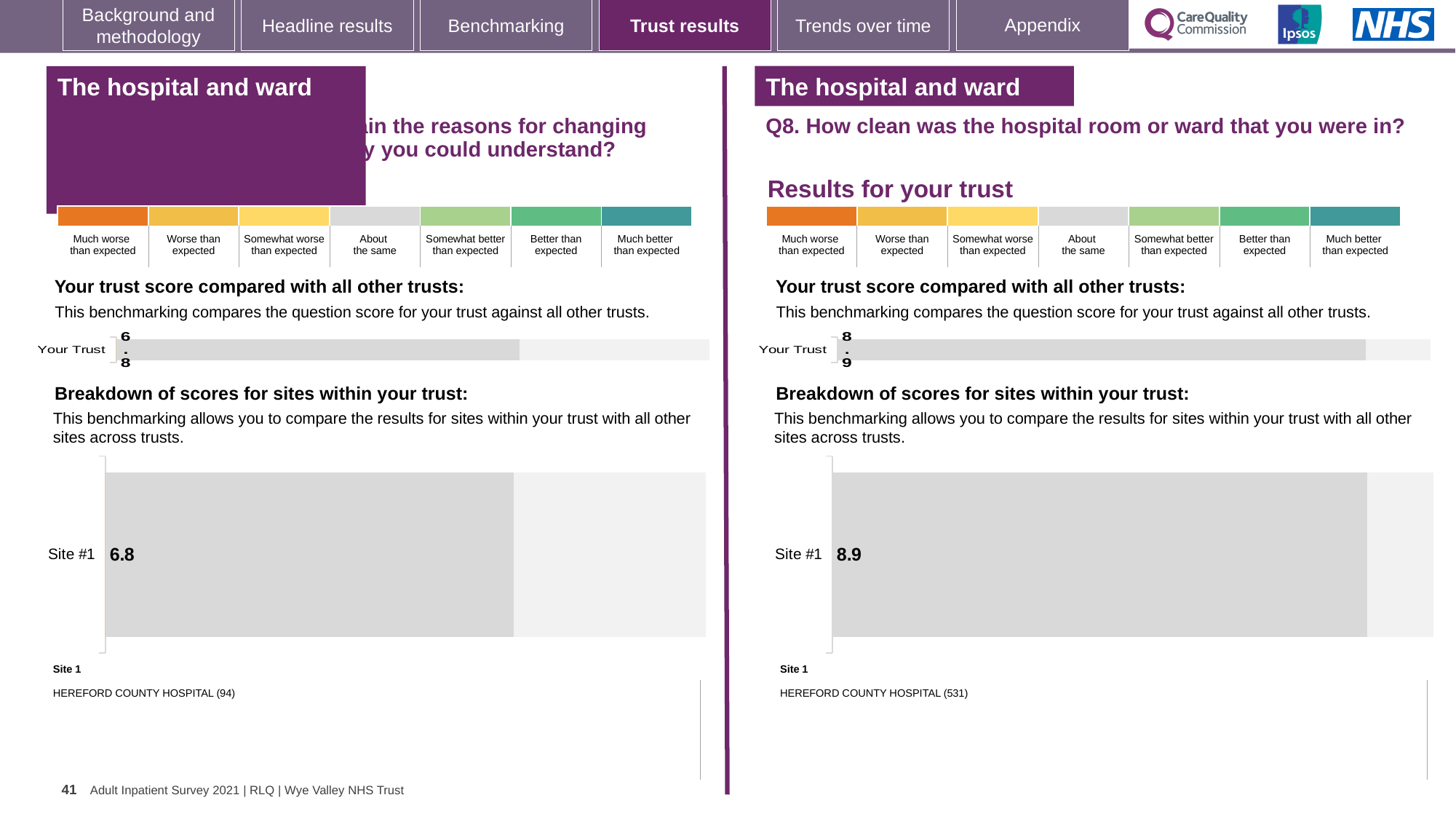
How many sites are shown in the right-hand 'Breakdown of scores for sites within your trust' chart for Q8? 1 Which hospital is listed as Site 1 beneath the right-hand Q8 breakdown chart? HEREFORD COUNTY HOSPITAL (531) On the right-hand Q8 charts, what is the difference between the Site #1 score and the Your Trust score? 0 How many sites are shown in the left-hand 'Breakdown of scores for sites within your trust' chart? 1 On the left-hand 'Your trust score compared with all other trusts' chart, what is the score shown for Your Trust? 6.8 On the right-hand 'Breakdown of scores for sites within your trust' chart for Q8, what is the score for Site #1? 8.9 What is the difference between the Your Trust score on the right-hand Q8 chart and the Your Trust score on the left-hand chart? 2.1 On the right-hand chart for Q8 (How clean was the hospital room or ward), what is the score shown for Your Trust? 8.9 What kind of chart is used to show the Site #1 score in the 'Breakdown of scores for sites within your trust' sections? Bar chart On the left-hand 'Breakdown of scores for sites within your trust' chart, what is the score for Site #1? 6.8 What number appears in brackets after HEREFORD COUNTY HOSPITAL beneath the left-hand breakdown chart? 94 Which is larger: the Your Trust score on the left-hand chart or the Your Trust score on the right-hand Q8 chart? The right-hand Q8 chart (8.9)